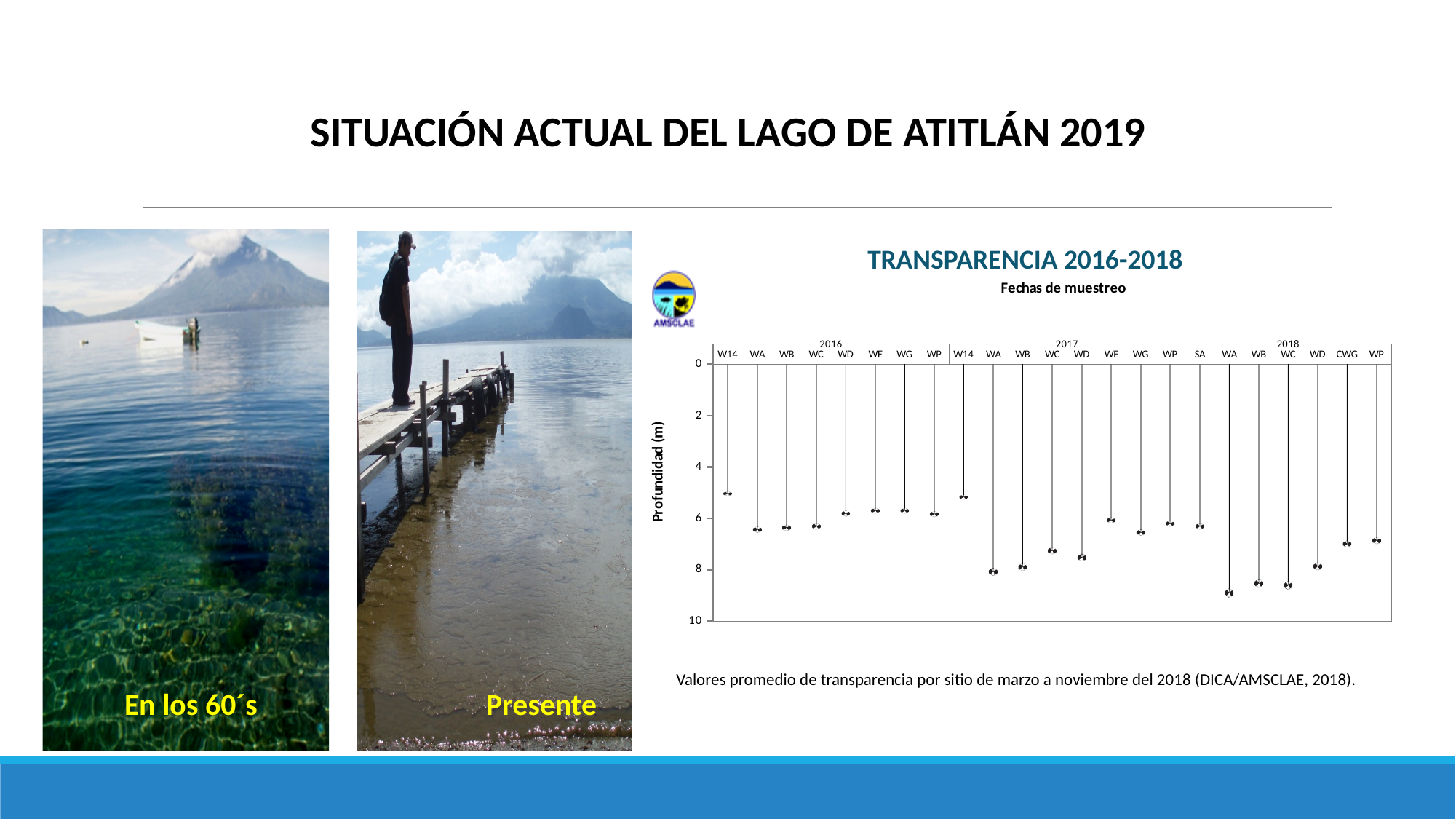
How many sampling sites are plotted under the year 2016 in the TRANSPARENCIA 2016-2018 chart? 8 What is the label of the vertical axis of the TRANSPARENCIA 2016-2018 chart? Profundidad (m) How many sampling points are plotted in the TRANSPARENCIA 2016-2018 chart? 23 In the TRANSPARENCIA 2016-2018 chart, is the depth for W14 in 2016 greater or less than 6 m? less In the TRANSPARENCIA 2016-2018 chart, which has the greater depth: WA in 2016 or WA in 2017? WA in 2017 In the TRANSPARENCIA 2016-2018 chart, which sampling point reaches the greatest depth? WA (2018) In the TRANSPARENCIA 2016-2018 chart, is the depth for WC in 2017 greater or less than 6 m? greater In the TRANSPARENCIA 2016-2018 chart, is the depth for WA in 2018 greater or less than 8 m? greater In the TRANSPARENCIA 2016-2018 chart, which has the greater depth: W14 in 2017 or WB in 2018? WB in 2018 How many sampling sites are plotted under the year 2018 in the TRANSPARENCIA 2016-2018 chart? 7 What is the maximum value shown on the vertical axis of the TRANSPARENCIA 2016-2018 chart? 10 What is the title of the chart on the right side of the slide? TRANSPARENCIA 2016-2018